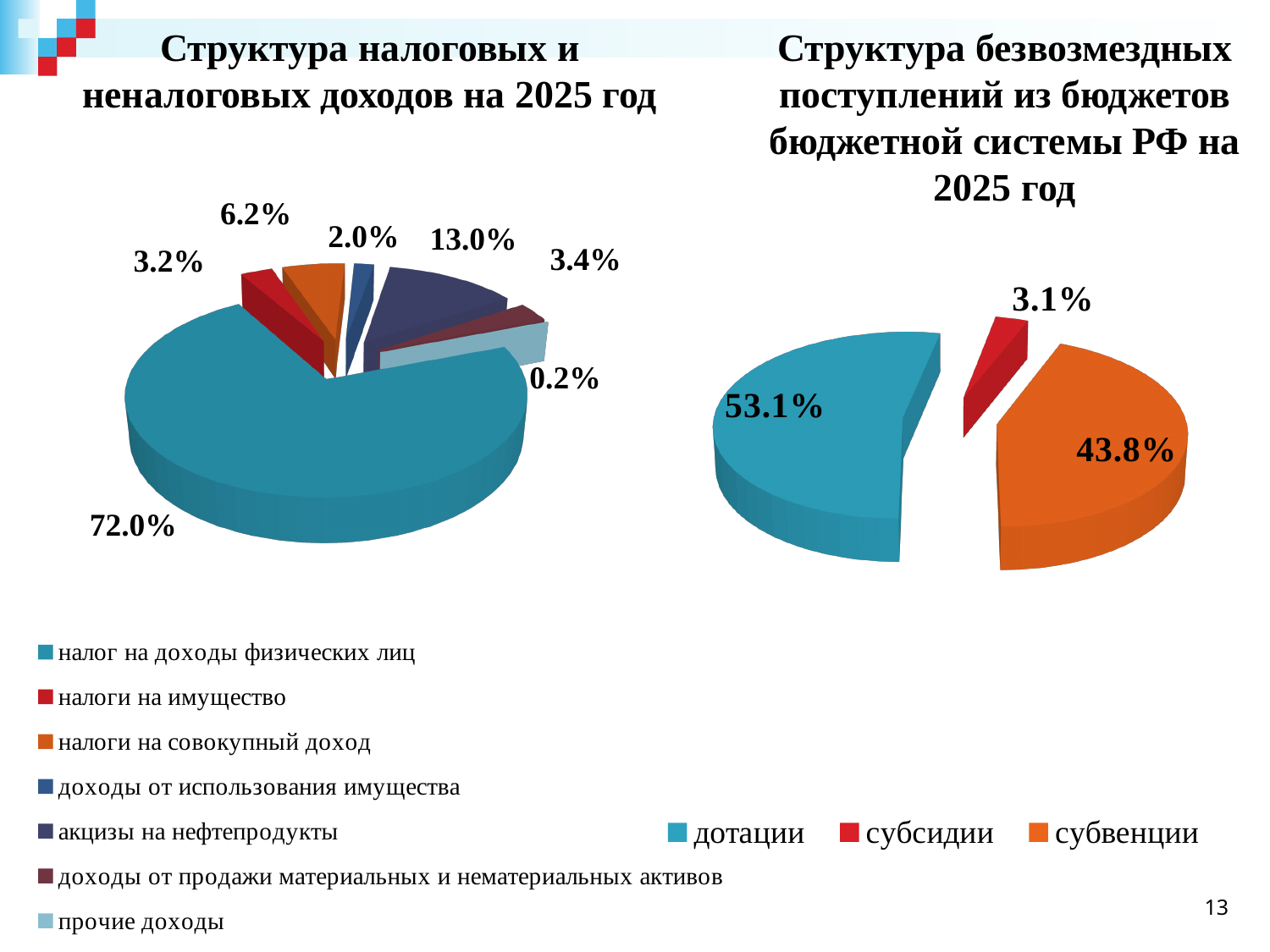
In the chart 'Структура безвозмездных поступлений из бюджетов бюджетной системы РФ на 2025 год', which category has the smallest share? субсидии In the chart 'Структура налоговых и неналоговых доходов на 2025 год', which category has the largest share? налог на доходы физических лиц In the chart 'Структура налоговых и неналоговых доходов на 2025 год', which category has the smallest share? прочие доходы In the chart 'Структура налоговых и неналоговых доходов на 2025 год', how many categories does the legend list? 7 What type of chart is used for 'Структура безвозмездных поступлений из бюджетов бюджетной системы РФ на 2025 год'? pie chart In the chart 'Структура налоговых и неналоговых доходов на 2025 год', what share does 'налоги на совокупный доход' have? 6.2% In the chart 'Структура безвозмездных поступлений из бюджетов бюджетной системы РФ на 2025 год', which is larger: 'дотации' or 'субвенции'? дотации In the chart 'Структура налоговых и неналоговых доходов на 2025 год', what is the difference between the shares of 'акцизы на нефтепродукты' and 'налоги на совокупный доход'? 6.8% In the chart 'Структура налоговых и неналоговых доходов на 2025 год', what share does 'налог на доходы физических лиц' have? 72.0% In the chart 'Структура безвозмездных поступлений из бюджетов бюджетной системы РФ на 2025 год', what share do 'дотации' have? 53.1% In the chart 'Структура безвозмездных поступлений из бюджетов бюджетной системы РФ на 2025 год', what share do 'субвенции' have? 43.8% In the chart 'Структура налоговых и неналоговых доходов на 2025 год', what share does 'акцизы на нефтепродукты' have? 13.0%